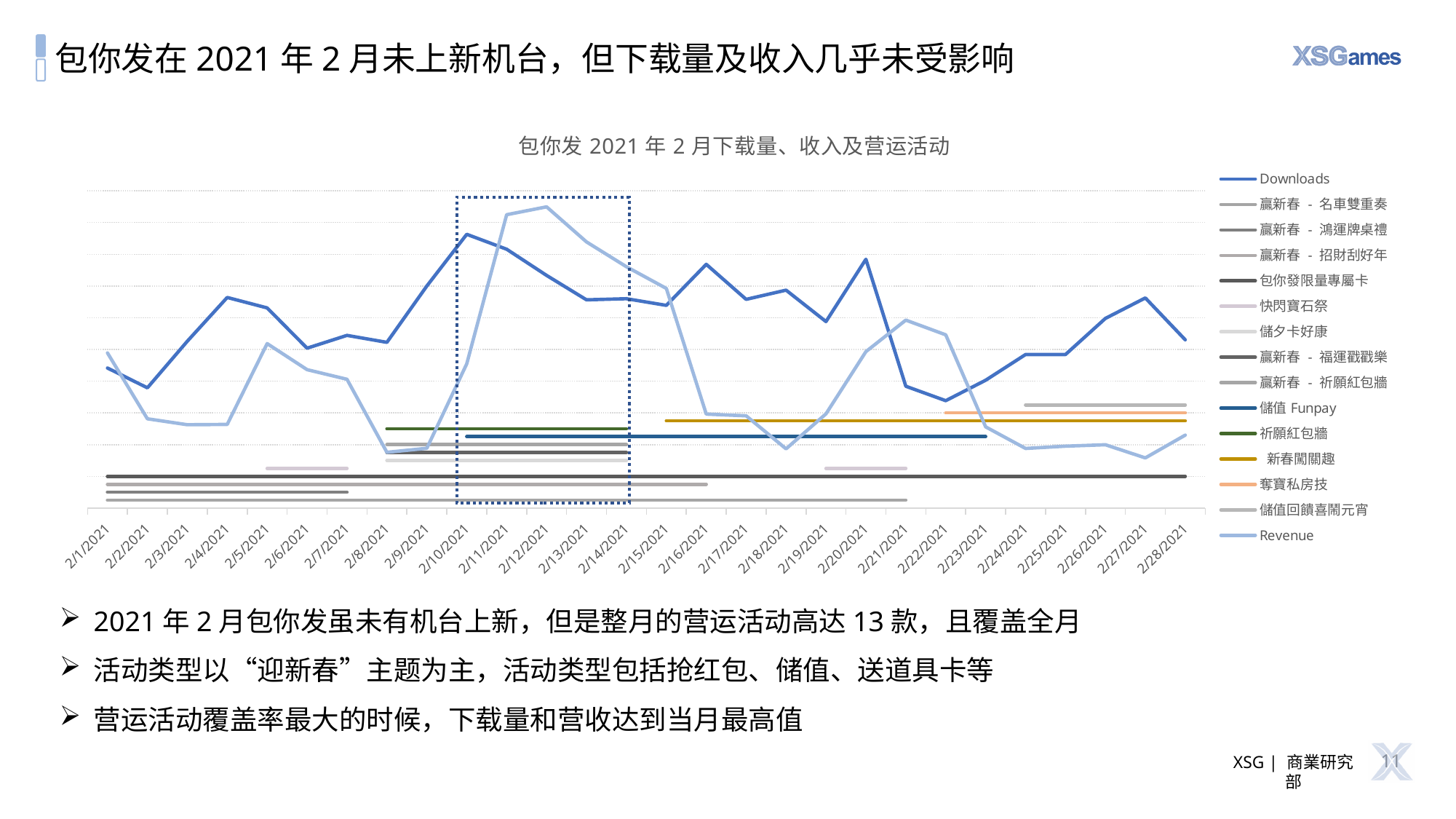
Which is larger, Downloads on 2/10/2021 or Downloads on 2/2/2021? 2/10/2021 Does the Downloads line rise or fall from 2/23/2021 to 2/27/2021? rise Which legend entry is drawn in a gold/yellow colour? 新春闖關趣 Does the Revenue line rise or fall from 2/12/2021 to 2/16/2021? fall How many dates are shown along the x axis of the chart? 28 What kind of chart is shown on the slide? line chart On which date does the Revenue line reach its highest point? 2/12/2021 How many series does the chart legend list? 15 Which is larger, Revenue on 2/12/2021 or Revenue on 2/1/2021? 2/12/2021 On which date does the Downloads line reach its highest point? 2/10/2021 What is the title of the chart? 包你发 2021 年 2 月下载量、收入及营运活动 On 2/16/2021, which line is higher, Downloads or Revenue? Downloads